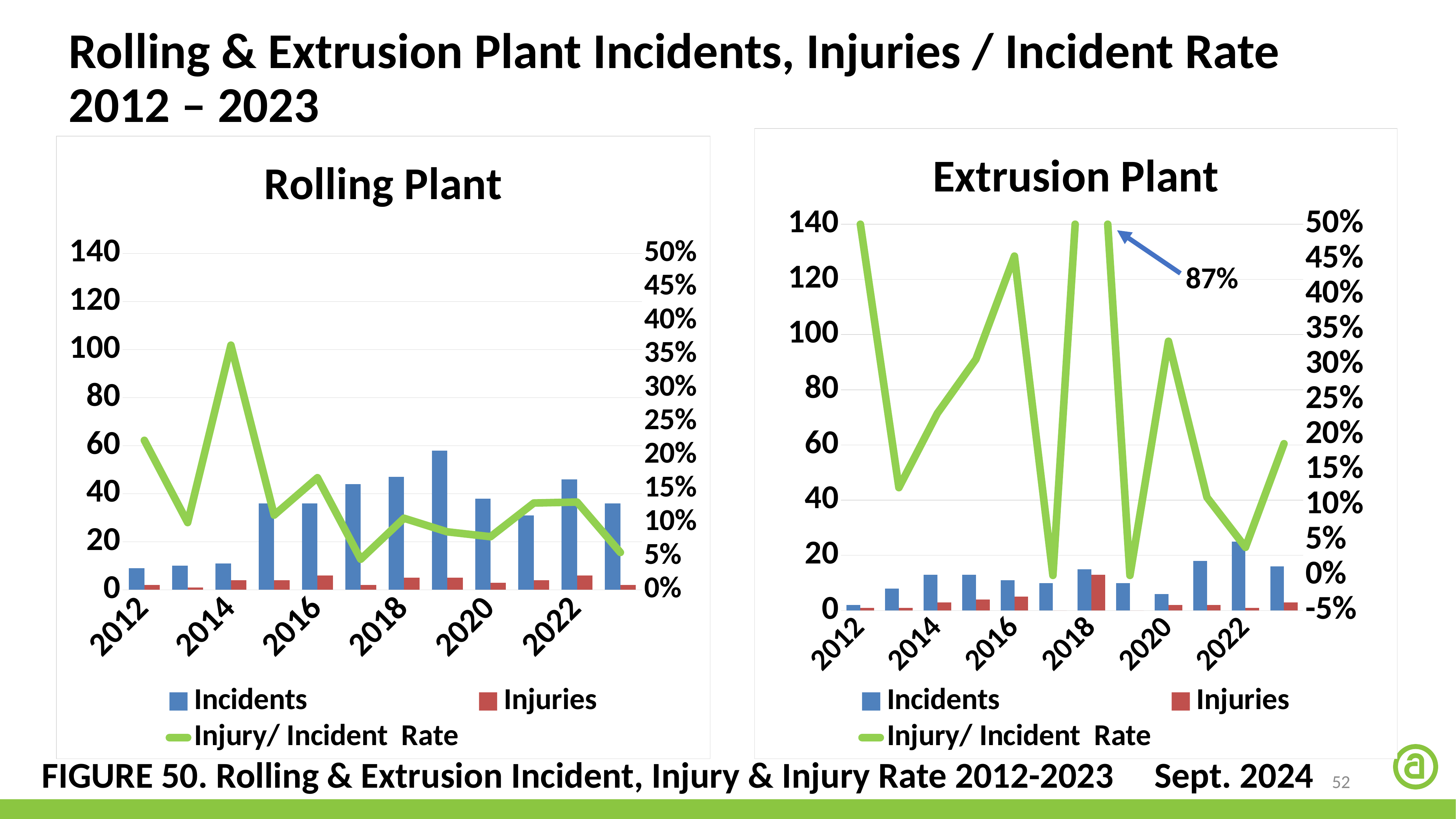
In the Extrusion Plant chart, does the Injury/Incident Rate rise or fall from 2022 to 2023? rise In the Extrusion Plant chart, which year has the lowest number of Incidents? 2012 How many series does the legend of the Extrusion Plant chart list? 3 In the Rolling Plant chart, is the Injury/Incident Rate for 2014 greater or less than 30%? greater In the Extrusion Plant chart, what Injury/Incident Rate value is called out with an arrow annotation? 87% In the Rolling Plant chart, which year has the highest number of Incidents? 2019 In the Rolling Plant chart, is the Incidents value for 2019 greater or less than 40? greater In the Extrusion Plant chart, which year has the highest number of Incidents? 2022 How many years are plotted on the x axis of the Rolling Plant chart? 12 What kind of chart is the Rolling Plant chart? A bar chart combined with a line In the Rolling Plant chart, is the Incidents value for 2012 greater or less than 20? less In the Rolling Plant chart, which year has more Incidents, 2012 or 2019? 2019